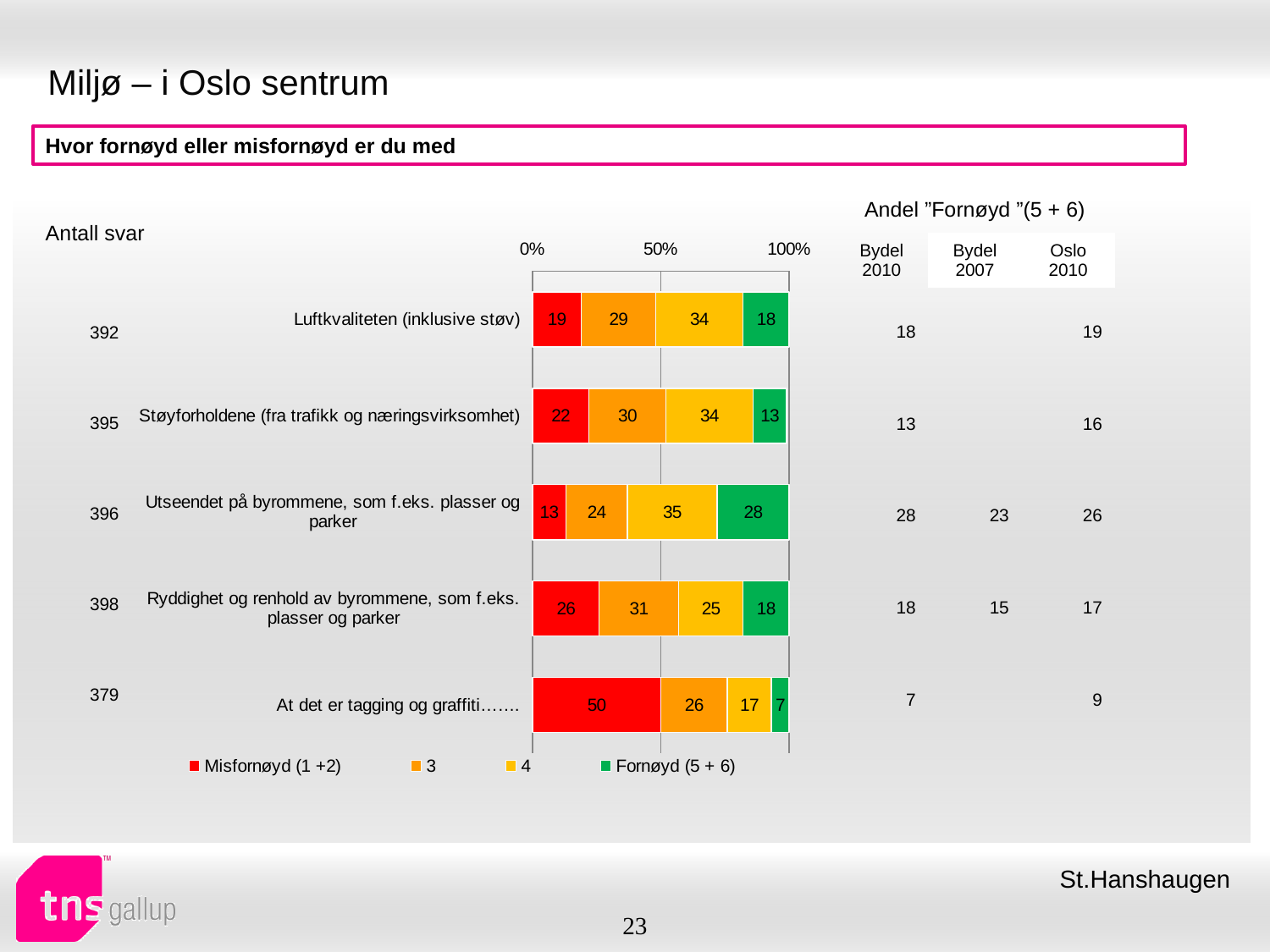
What is the difference between the "Misfornøyd (1 +2)" value for "At det er tagging og graffiti" and for "Luftkvaliteten (inklusive støv)"? 31 What kind of chart is shown on the slide? Stacked bar chart Which has the larger "Fornøyd (5 + 6)" value: "Luftkvaliteten (inklusive støv)" or "Støyforholdene (fra trafikk og næringsvirksomhet)"? Luftkvaliteten (inklusive støv) Which category has the lowest "Fornøyd (5 + 6)" value? At det er tagging og graffiti How many categories are shown in the chart? 5 What is the total of the stacked bar for "Luftkvaliteten (inklusive støv)"? 100 Which category has the highest "Misfornøyd (1 +2)" value? At det er tagging og graffiti What is the value of the "4" segment for "Ryddighet og renhold av byrommene, som f.eks. plasser og parker"? 25 How many series does the legend list? 4 What is the value of the "Misfornøyd (1 +2)" segment for "Luftkvaliteten (inklusive støv)"? 19 What is the value of the "Fornøyd (5 + 6)" segment for "Utseendet på byrommene, som f.eks. plasser og parker"? 28 Which legend entry is shown in red? Misfornøyd (1 +2)